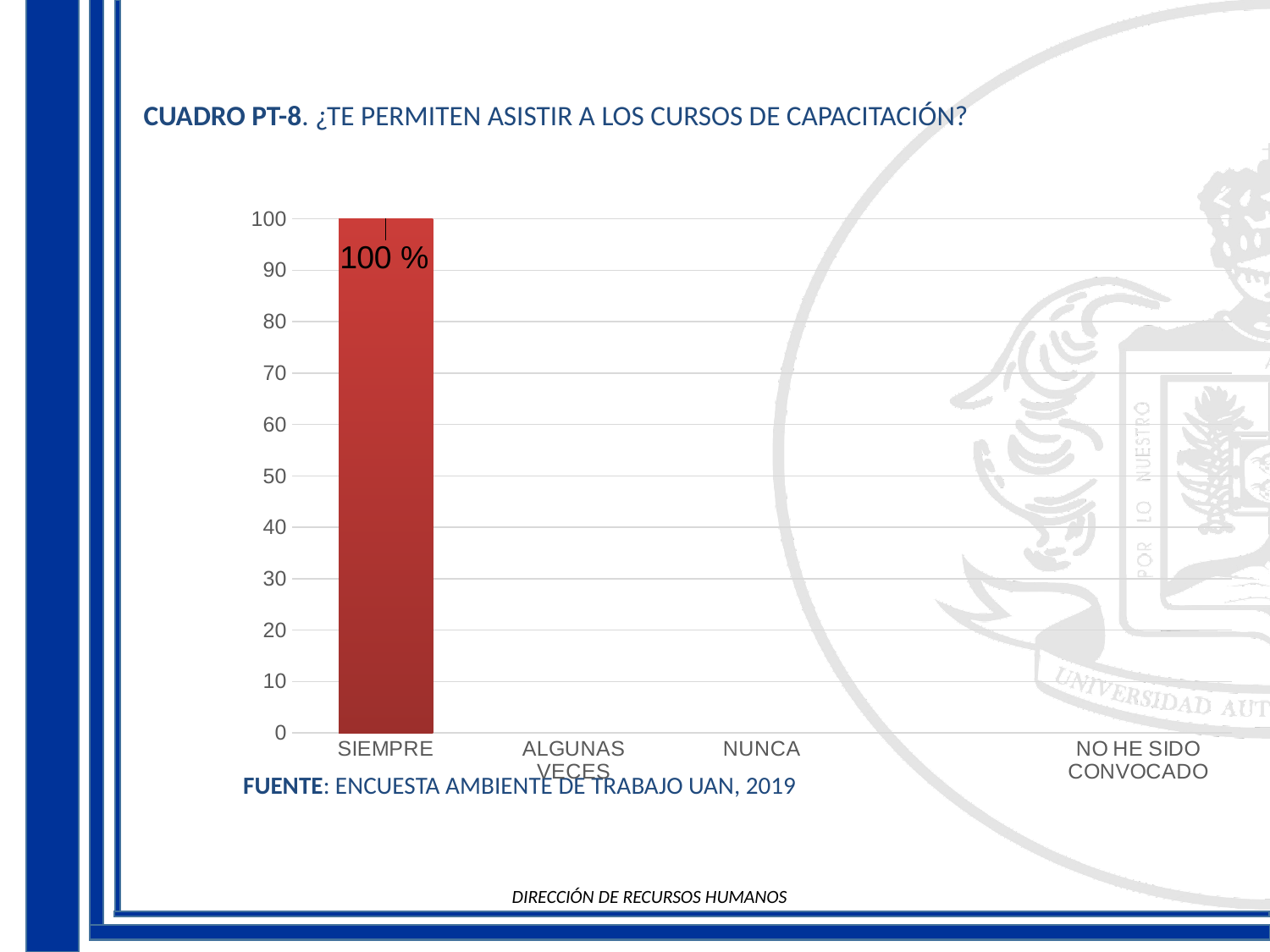
Which is larger, the value for SIEMPRE or the value for NO HE SIDO CONVOCADO? SIEMPRE What is the title of the chart? CUADRO PT-8. ¿TE PERMITEN ASISTIR A LOS CURSOS DE CAPACITACIÓN? What kind of chart is shown on the slide? bar chart Is the value for SIEMPRE greater or less than 50? greater How many categories are shown on the x axis? 4 What is the source cited below the chart? ENCUESTA AMBIENTE DE TRABAJO UAN, 2019 Which category has the highest value? SIEMPRE What is the value for SIEMPRE? 100 % What is the maximum value shown on the y axis? 100